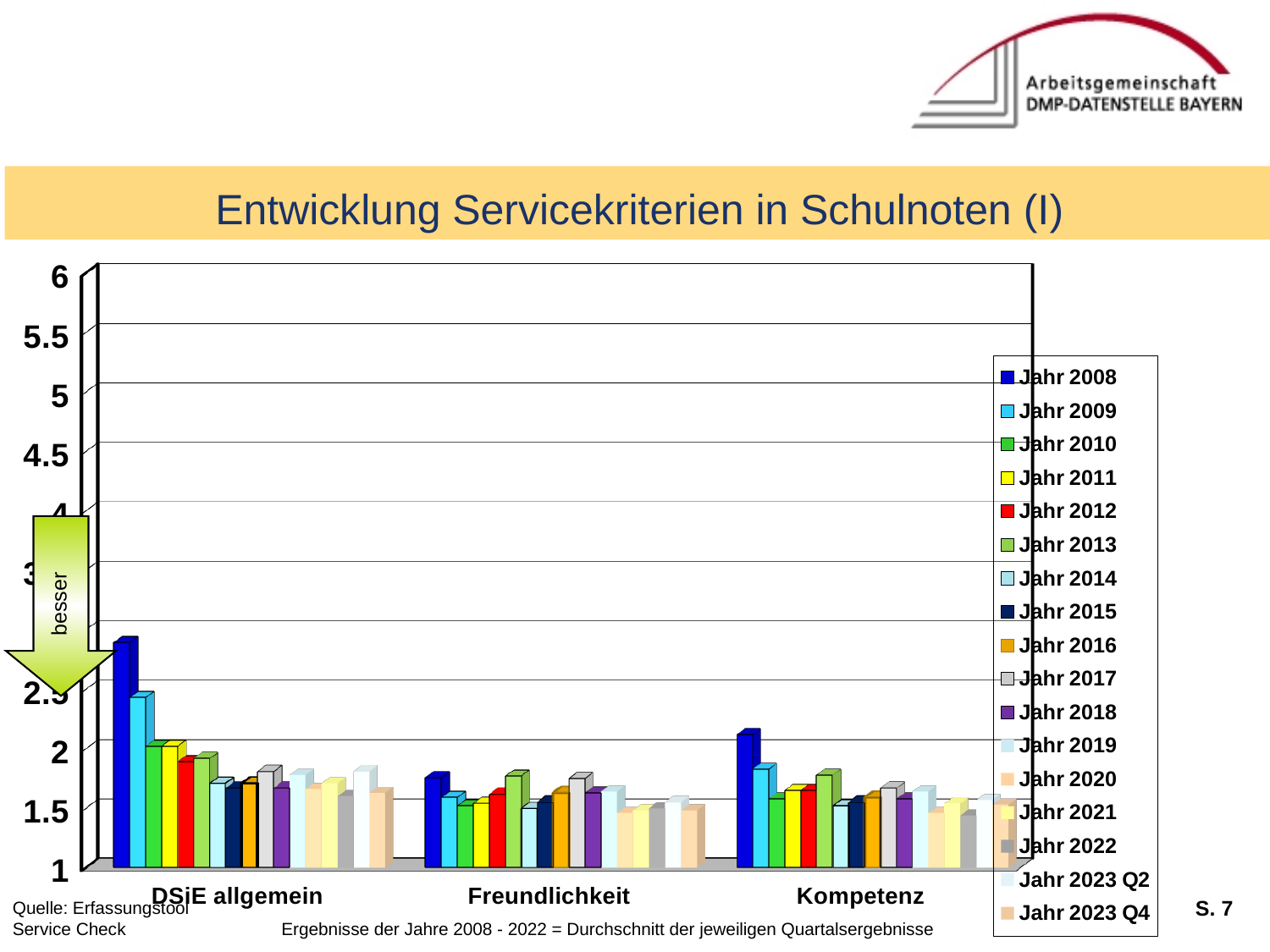
What is the title of the chart on the slide? Entwicklung Servicekriterien in Schulnoten (I) Which year has the highest value in the Kompetenz category? Jahr 2008 In the DSiE allgemein category, do the values generally rise or fall from Jahr 2008 to the later years? fall Is the value for Jahr 2008 in DSiE allgemein greater or less than 2.5? greater Is the value for Jahr 2008 in Kompetenz greater or less than 2.5? less In the DSiE allgemein category, which is larger: the value for Jahr 2008 or the value for Jahr 2009? Jahr 2008 Is the value for Jahr 2008 in Freundlichkeit greater or less than 2? less How many series does the chart's legend list? 17 Which is larger: the Jahr 2008 value for DSiE allgemein or the Jahr 2008 value for Kompetenz? DSiE allgemein What kind of chart is shown on the slide? bar chart How many categories are shown on the x axis of the chart? 3 Which year has the highest value in the DSiE allgemein category? Jahr 2008